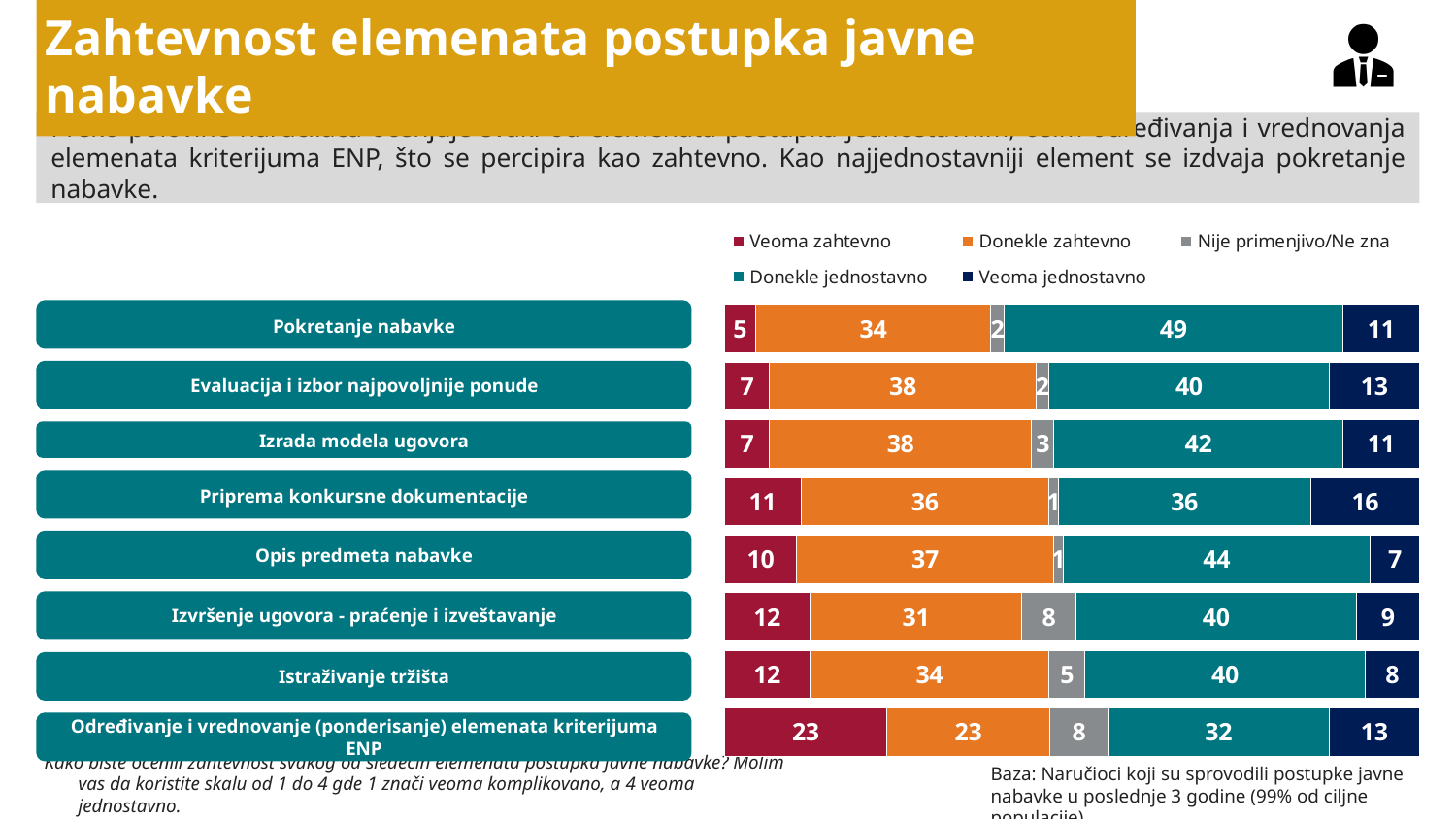
Which is larger: the 'Veoma jednostavno' value for 'Priprema konkursne dokumentacije' or for 'Opis predmeta nabavke'? Priprema konkursne dokumentacije What type of chart is shown on the slide? stacked bar chart Which category has the highest 'Donekle jednostavno' value? Pokretanje nabavke Which category has the lowest 'Veoma zahtevno' value? Pokretanje nabavke What is the 'Veoma zahtevno' value for 'Određivanje i vrednovanje (ponderisanje) elemenata kriterijuma ENP'? 23 How many categories (elements of the procurement procedure) are shown in the chart? 8 Which category has the highest 'Veoma zahtevno' value? Određivanje i vrednovanje (ponderisanje) elemenata kriterijuma ENP What colour represents the 'Donekle zahtevno' series in the chart? orange What is the 'Donekle jednostavno' value for 'Opis predmeta nabavke'? 44 What is the 'Veoma jednostavno' value for 'Pokretanje nabavke'? 11 How many series does the legend list? 5 What is the difference between the 'Donekle jednostavno' values for 'Pokretanje nabavke' and 'Priprema konkursne dokumentacije'? 13